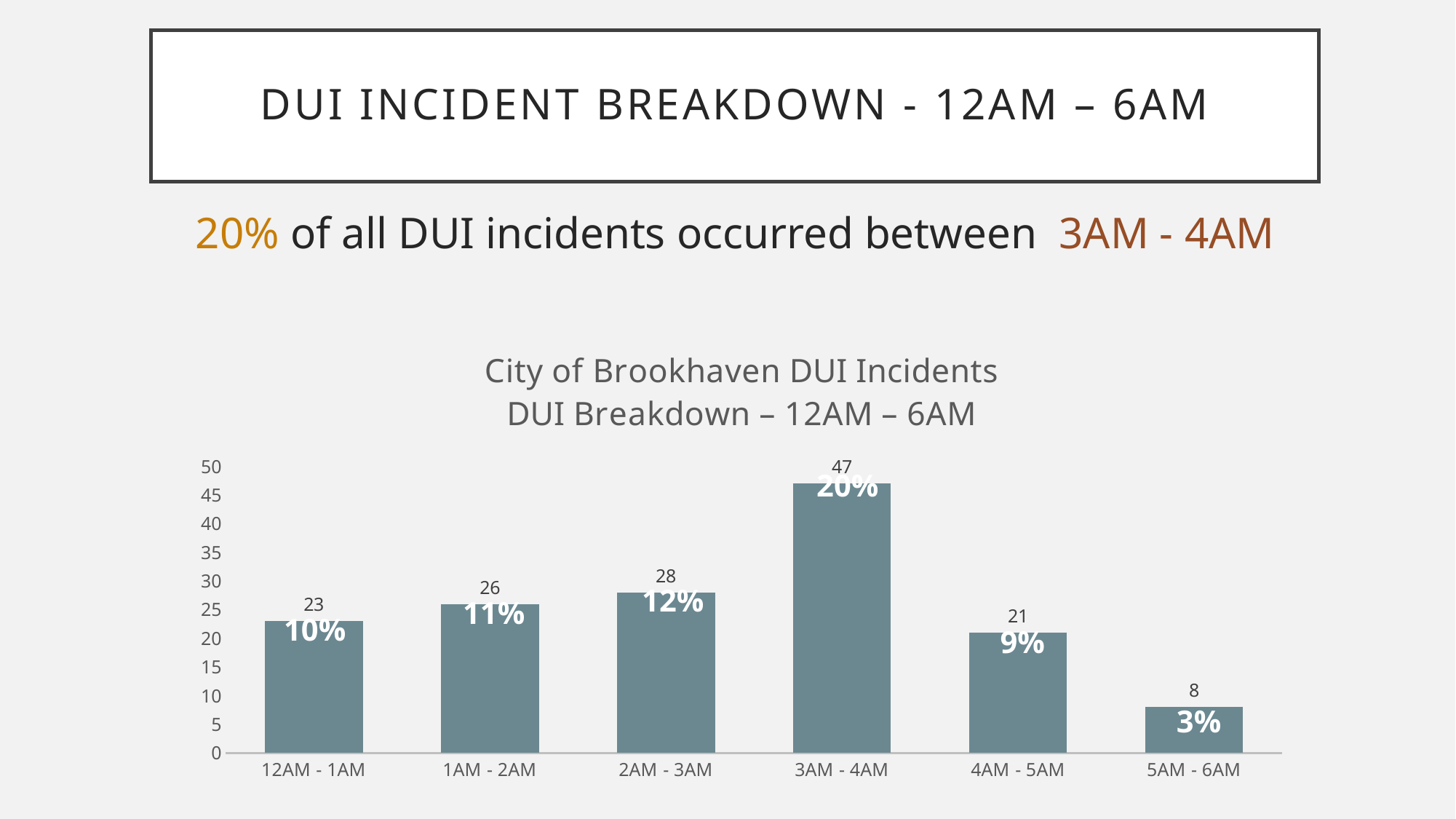
Is the value for 2AM - 3AM greater or less than 30? less What is the difference in DUI incidents between 3AM - 4AM and 4AM - 5AM? 26 What is the total number of DUI incidents across all six time periods shown? 153 How many time periods are shown on the x axis of the chart? 6 What kind of chart is shown on the slide? bar chart Which time period has the highest number of DUI incidents? 3AM - 4AM Which time period has the lowest number of DUI incidents? 5AM - 6AM How many DUI incidents occurred between 3AM - 4AM? 47 Which has more DUI incidents, 12AM - 1AM or 1AM - 2AM? 1AM - 2AM What is the title of the chart? City of Brookhaven DUI Incidents DUI Breakdown – 12AM – 6AM What percentage label is shown on the 2AM - 3AM bar? 12% How many DUI incidents occurred between 5AM - 6AM? 8